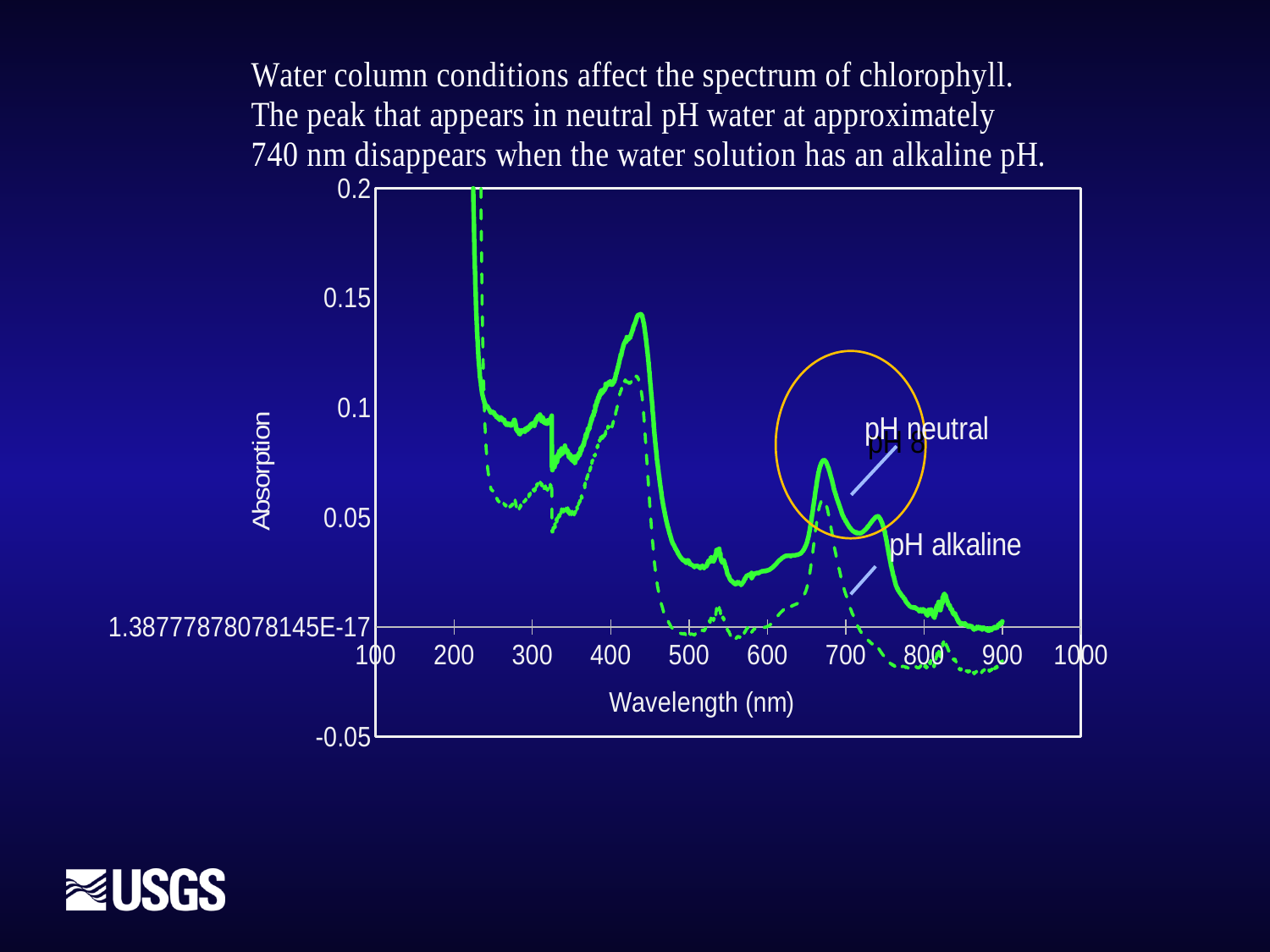
How many series (curves) are plotted on the chart? 2 Between 450 nm and 500 nm, does the pH neutral curve rise or fall? fall What is the label of the x axis? Wavelength (nm) What is the label of the y axis? Absorption Near 440 nm, which curve has the higher absorption, pH neutral or pH alkaline? pH neutral Which curve is drawn with a dashed line, pH neutral or pH alkaline? pH alkaline What kind of chart is shown on the slide? line chart Is the absorption of the pH neutral curve at 300 nm greater or less than 0.05? greater Is the peak absorption of the pH neutral curve near 440 nm greater or less than 0.1? greater Is the absorption of the pH neutral curve at its peak near 670 nm greater or less than 0.1? less Near 740 nm, which curve has the higher absorption, pH neutral or pH alkaline? pH neutral